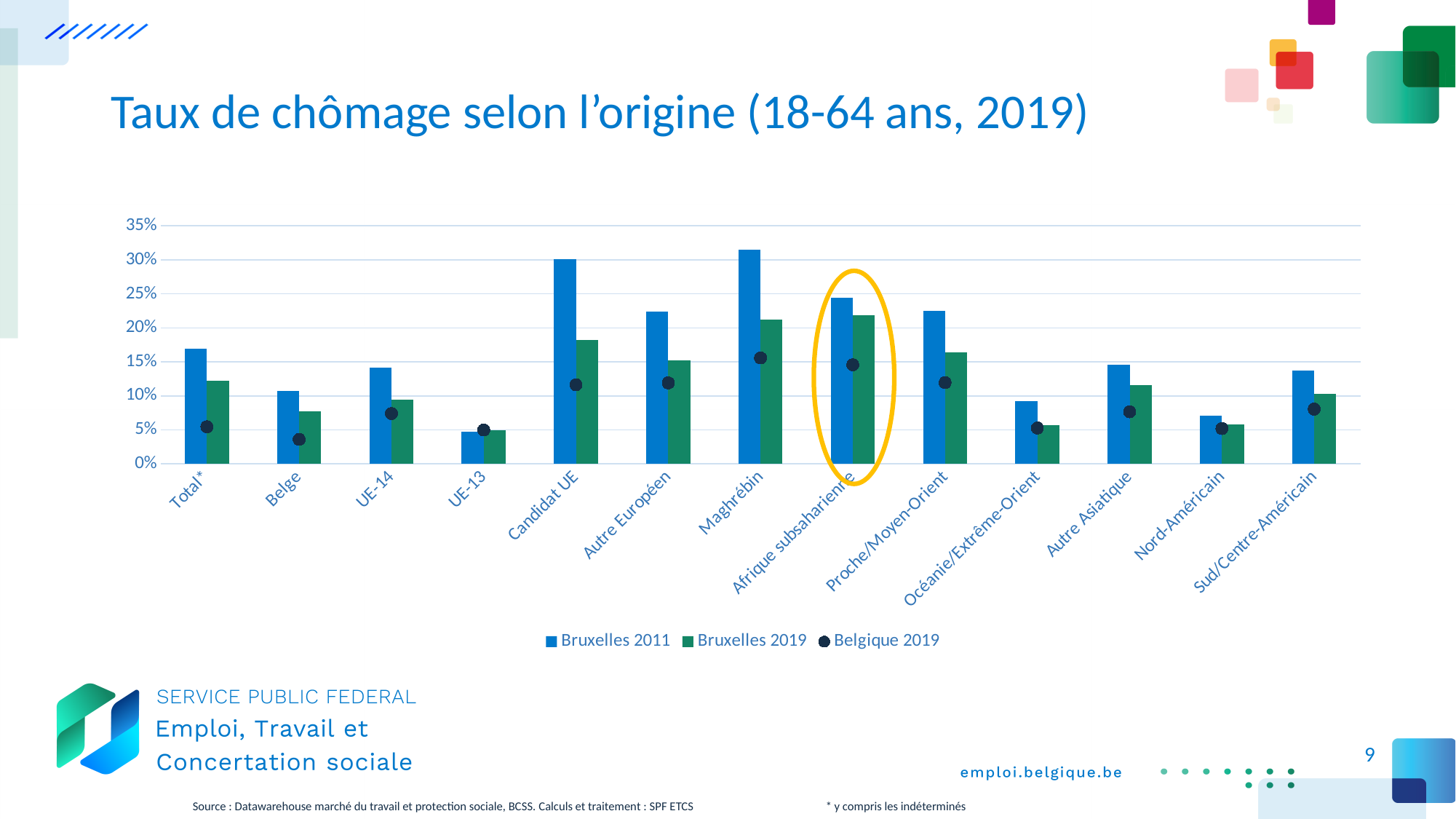
How many origin categories are shown on the x axis? 13 Which colour represents the Bruxelles 2019 series in the legend? green How many series does the legend list? 3 For Total*, which is larger: the Bruxelles 2011 value or the Bruxelles 2019 value? Bruxelles 2011 Is the Bruxelles 2019 value for Afrique subsaharienne greater or less than 20%? greater Is the Bruxelles 2019 value for Belge greater or less than 10%? less Which category has the highest Bruxelles 2011 value? Maghrébin Which category has the lowest Bruxelles 2011 value? UE-13 What kind of chart is this? combination chart: bars with a dot (line-marker) series Is the Bruxelles 2011 value for Maghrébin greater or less than 30%? greater What is the title of the chart? Taux de chômage selon l’origine (18-64 ans, 2019) Which has the larger Bruxelles 2011 value: Candidat UE or Autre Européen? Candidat UE